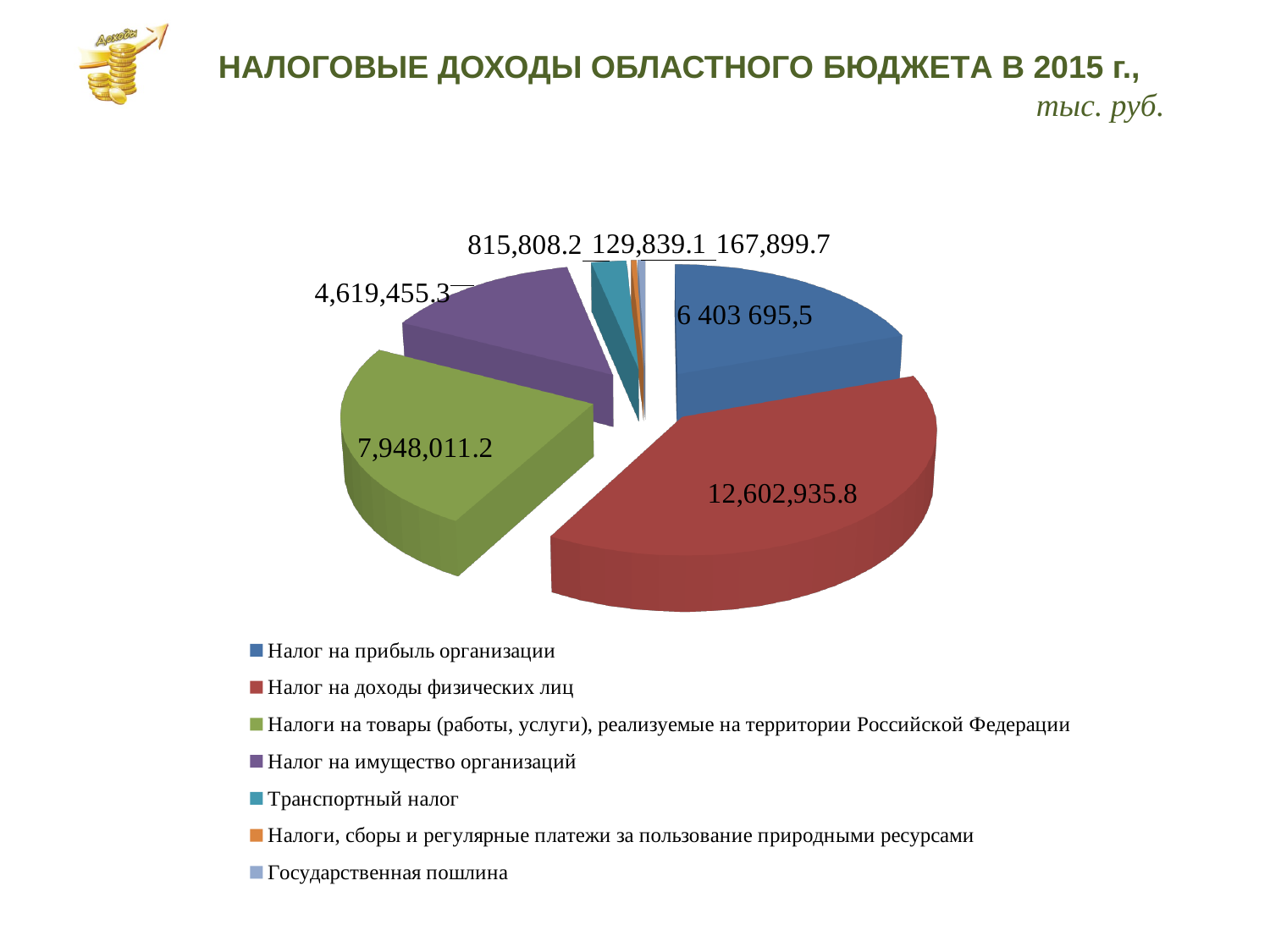
What is the value for Налог на доходы физических лиц? 12,602,935.8 Which category has the largest slice of the pie? Налог на доходы физических лиц Which is larger: the value for Налог на прибыль организации or the value for Налог на имущество организаций? Налог на прибыль организации What kind of chart is shown on the slide? Pie chart How many entries does the legend list? 7 Which category has the smallest slice of the pie? Налоги, сборы и регулярные платежи за пользование природными ресурсами What is the value for Транспортный налог? 815,808.2 What is the difference between the values for Налог на доходы физических лиц and Налоги на товары (работы, услуги), реализуемые на территории Российской Федерации? 4,654,924.6 What is the value for Налог на имущество организаций? 4,619,455.3 How many slices does the pie chart have? 7 What is the value for Налоги на товары (работы, услуги), реализуемые на территории Российской Федерации? 7,948,011.2 What is the value for Государственная пошлина? 167,899.7